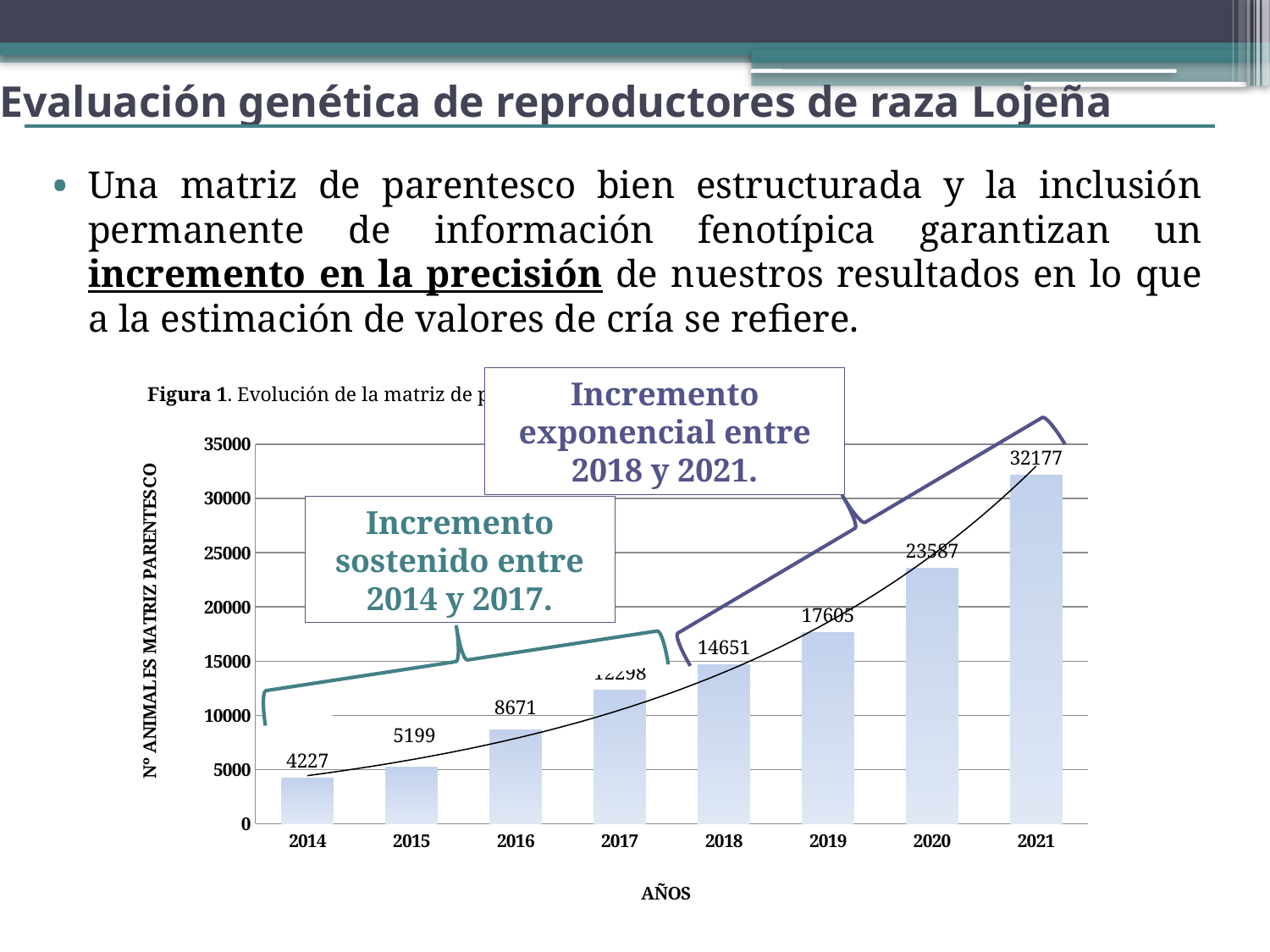
What is the difference between the values for 2021 and 2020? 8590 Which year has the highest value? 2021 How many years are shown on the x axis? 8 What is the value for 2016? 8671 What is the value for 2021? 32177 What is the value for 2014? 4227 What kind of chart is shown? bar chart Which is larger, the value for 2019 or the value for 2018? 2019 Is the value for 2017 greater or less than 10000? greater What is the value for 2018? 14651 What is the difference between the values for 2015 and 2014? 972 Which year has the lowest value? 2014